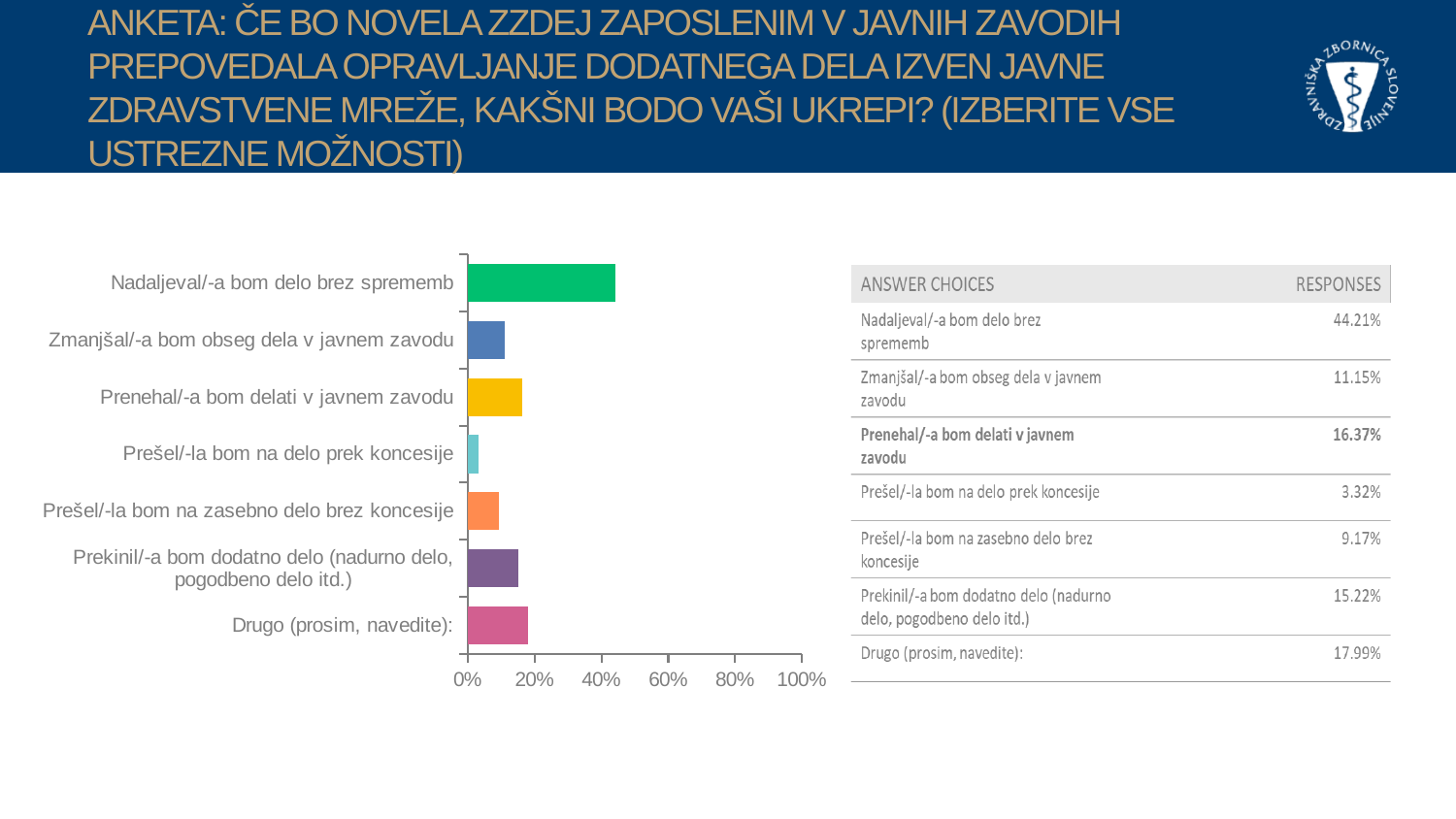
Which answer choice has the lowest response share? Prešel/-la bom na delo prek koncesije What is the response share for "Nadaljeval/-a bom delo brez sprememb"? 44.21% What is the response share for "Drugo (prosim, navedite):"? 17.99% What kind of chart is shown on the slide? bar chart What is the response share for "Prenehal/-a bom delati v javnem zavodu"? 16.37% Which answer choice has the highest response share? Nadaljeval/-a bom delo brez sprememb What colour is the bar for "Nadaljeval/-a bom delo brez sprememb"? green How many answer choices (categories) are plotted in the bar chart? 7 Is the value for "Nadaljeval/-a bom delo brez sprememb" greater or less than 40%? greater Which has a larger response share: "Drugo (prosim, navedite):" or "Zmanjšal/-a bom obseg dela v javnem zavodu"? Drugo (prosim, navedite): What is the response share for "Prešel/-la bom na zasebno delo brez koncesije"? 9.17% What is the difference in response share between "Nadaljeval/-a bom delo brez sprememb" and "Zmanjšal/-a bom obseg dela v javnem zavodu"? 33.06%